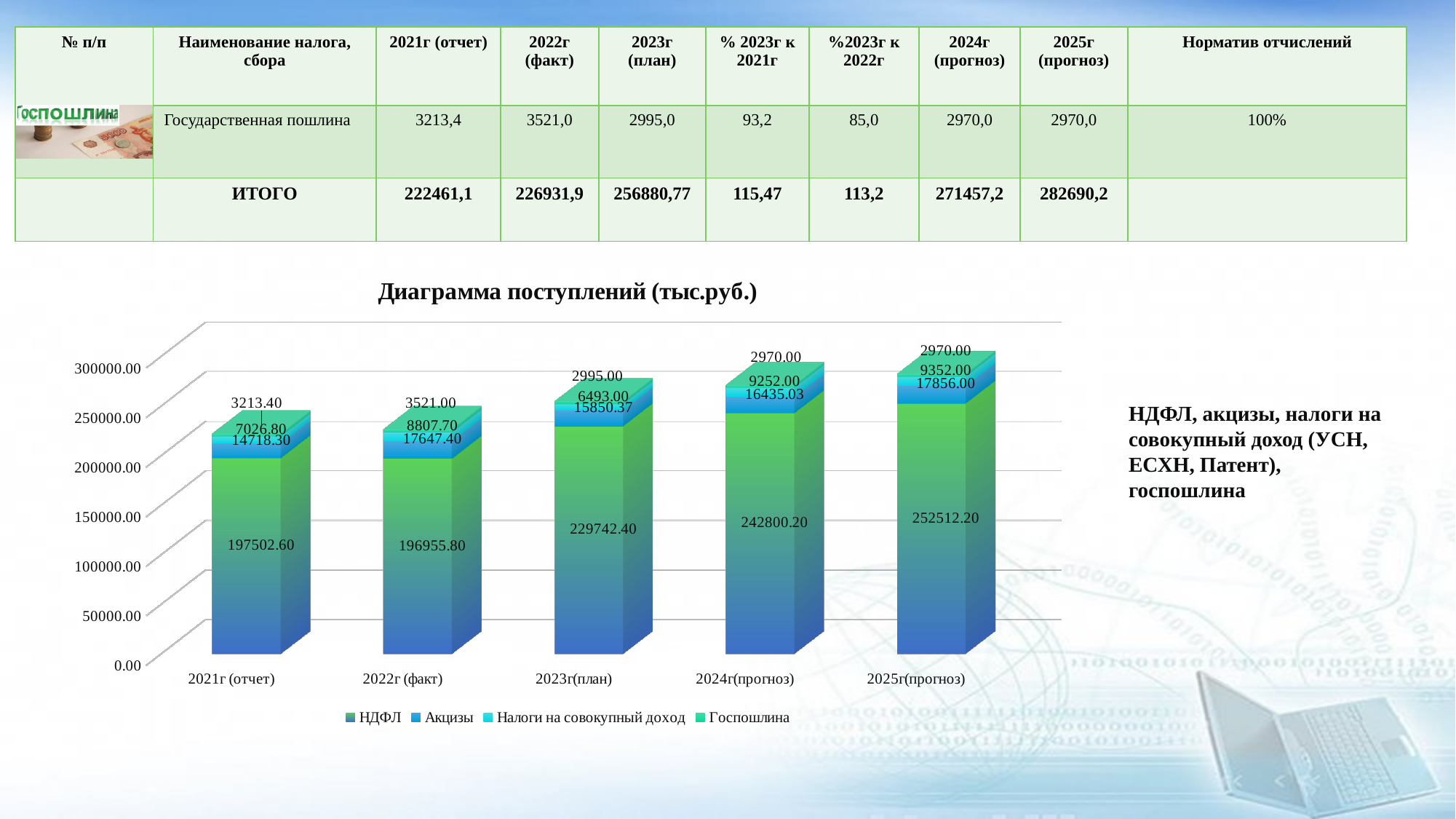
What is the value of НДФЛ for 2023г(план) in the chart? 229742.40 What type of chart is shown under the title 'Диаграмма поступлений (тыс.руб.)'? bar chart How many series does the legend of the chart list? 4 What is the value of Налоги на совокупный доход for 2024г(прогноз) in the chart? 9252.00 Which year has the lowest Госпошлина value in the chart? 2024г(прогноз) and 2025г(прогноз) (2970.00) What is the difference between the НДФЛ values for 2025г(прогноз) and 2024г(прогноз)? 9712.00 What is the total of the stacked bar for 2021г (отчет)? 222461.10 What is the value of Госпошлина for 2022г (факт) in the chart? 3521.00 Which is larger: Акцизы for 2022г (факт) or Акцизы for 2023г(план)? 2022г (факт) How many categories (years) are shown on the x axis of the chart? 5 What is the value of Акцизы for 2025г(прогноз) in the chart? 17856.00 Which year has the highest НДФЛ value in the chart? 2025г(прогноз)